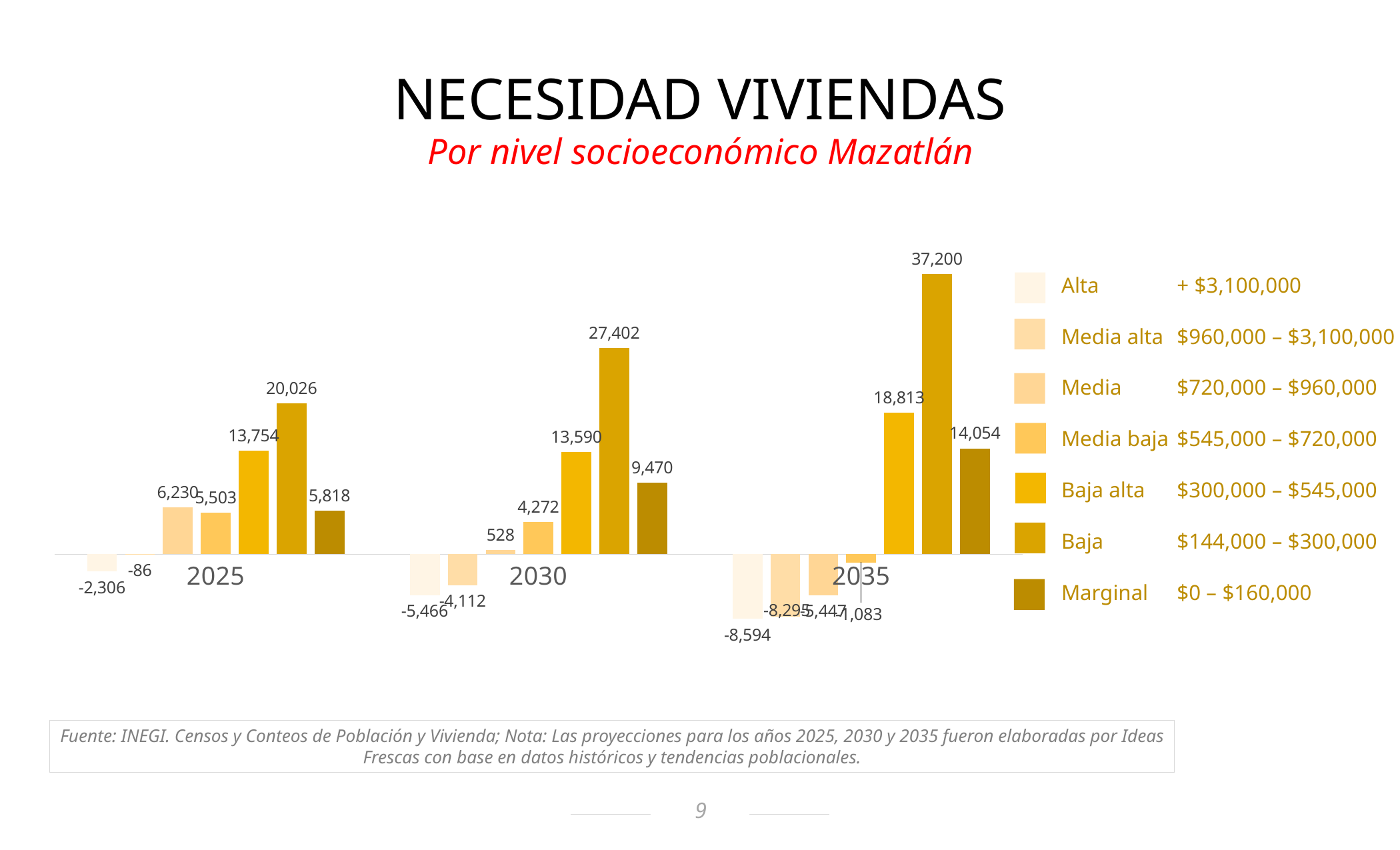
What is the value for Marginal in 2030? 9,470 Does the value for Baja rise or fall from 2025 to 2035? Rise How many year groups are shown on the x axis? 3 Which is larger, Baja alta in 2025 or Baja alta in 2030? Baja alta in 2025 What kind of chart is shown on the slide? Bar chart Which series has the highest value in 2030? Baja What is the value for Alta in 2025? -2,306 What is the value for Baja in 2035? 37,200 Which series has the lowest value in 2035? Alta What is the value for Media in 2030? 528 What is the difference between the Baja values for 2035 and 2025? 17,174 How many series does the legend list? 7